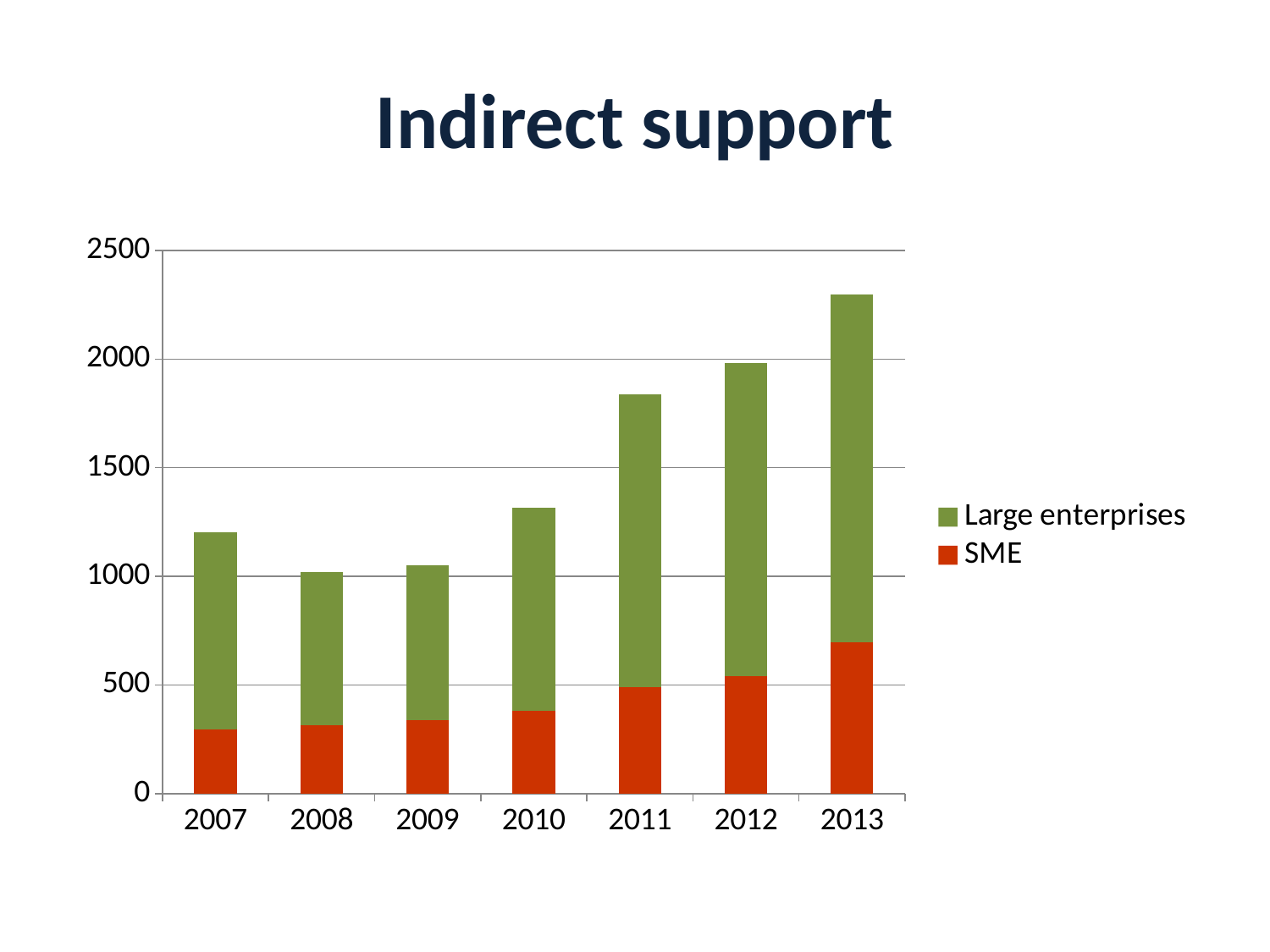
How many series does the legend list? 2 What is the title of the chart? Indirect support Is the total value for 2010 greater or less than 1500? less How many years are shown on the x axis of the chart? 7 Which year has the largest SME segment? 2013 Is the SME value for 2007 greater or less than 500? less Do the total bar heights rise or fall from 2010 to 2013? rise What kind of chart is shown on the slide? Stacked bar chart Is the total value for 2013 greater or less than 2000? greater Which year has the larger total bar, 2007 or 2013? 2013 Which year has the highest total bar? 2013